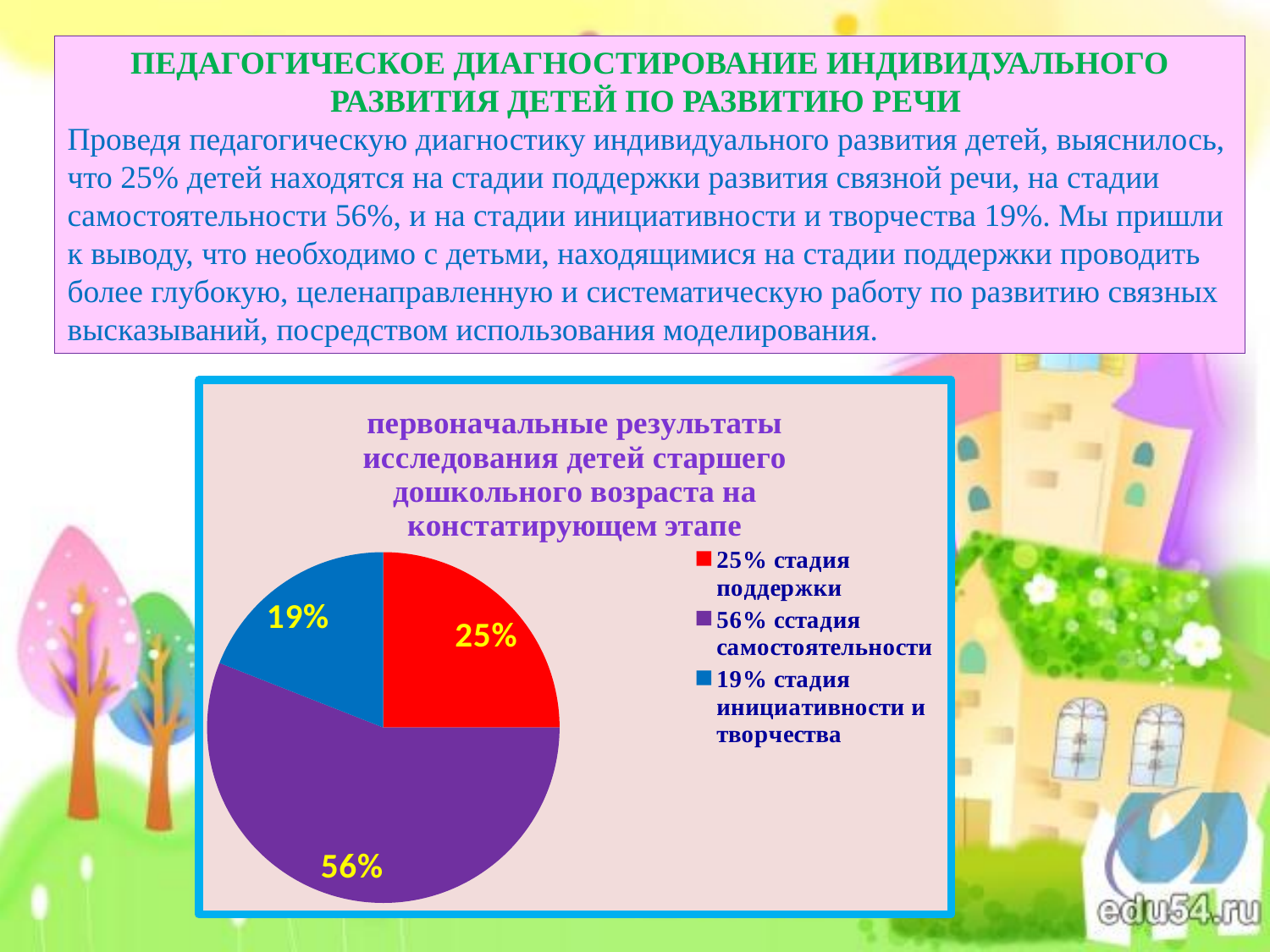
What is the difference between the 'стадия самостоятельности' and 'стадия поддержки' slices? 31% Which category has the smallest share of the pie? стадия инициативности и творчества What is the value for the 'стадия поддержки' slice? 25% Which category has the largest share of the pie? стадия самостоятельности What colour is the 'стадия самостоятельности' slice? purple How many slices does the pie chart have? 3 How many entries does the legend list? 3 What is the value for the 'стадия самостоятельности' slice? 56% What colour is the 'стадия поддержки' slice? red What kind of chart is shown on the slide? pie chart Which is larger: the 'стадия поддержки' slice or the 'стадия инициативности и творчества' slice? стадия поддержки What is the value for the 'стадия инициативности и творчества' slice? 19%